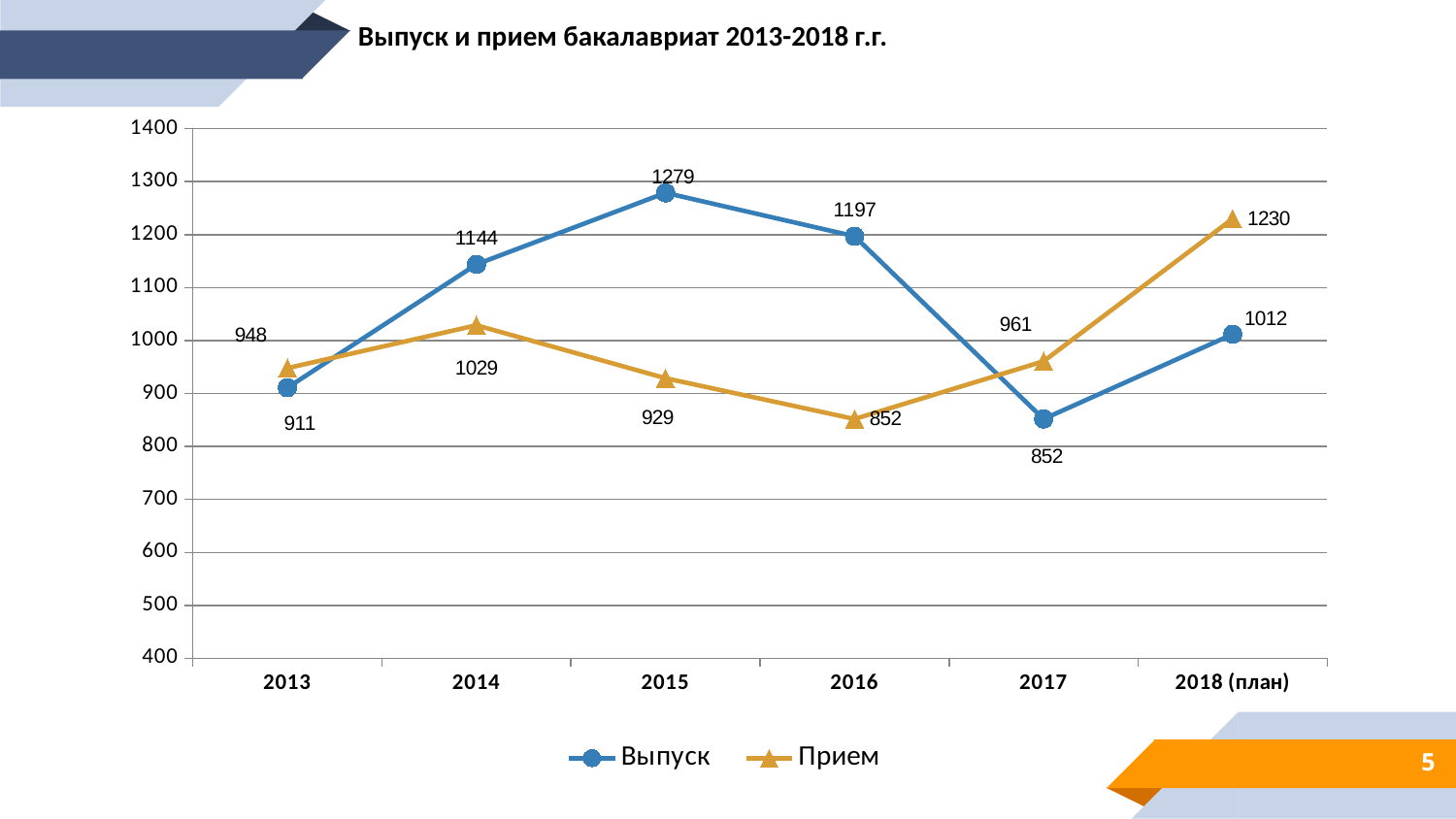
Which is larger in 2017, Выпуск or Прием? Прием What is the value of Прием in 2018 (план)? 1230 How many years are shown on the x axis? 6 What is the value of Выпуск in 2015? 1279 In which year is Выпуск highest? 2015 In which year is Прием lowest? 2016 Is the value of Выпуск in 2016 greater or less than 1100? greater Does Прием rise or fall from 2017 to 2018 (план)? rise What is the difference between Выпуск and Прием in 2015? 350 What is the value of Выпуск in 2017? 852 What kind of chart is shown on the slide? line chart How many series does the legend list? 2